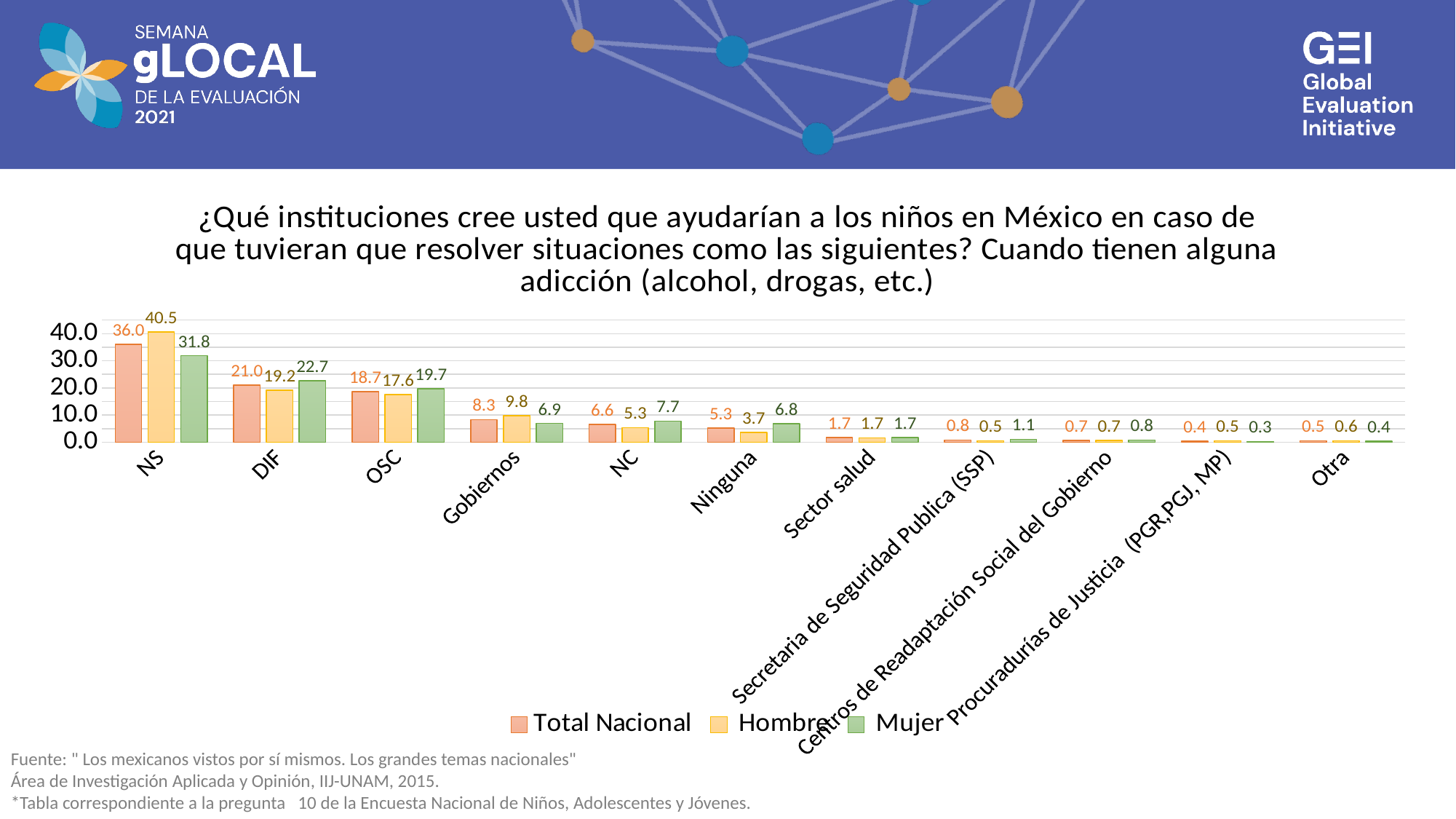
How many series does the legend list? 3 What is the difference between the Hombre and Mujer values for NS? 8.7 Which is larger for NC: the Total Nacional value or the Mujer value? Mujer What is the Hombre value for DIF? 19.2 Which category has the highest Mujer value? NS Which category has the lowest Hombre value? Secretaria de Seguridad Publica (SSP) and Procuradurías de Justicia (PGR,PGJ, MP) (both 0.5) Which series is shown in green in the legend? Mujer What kind of chart is shown on the slide? Bar chart How many categories are shown on the x axis? 11 What is the Mujer value for OSC? 19.7 What is the Total Nacional value for NS? 36.0 What is the Hombre value for Gobiernos? 9.8